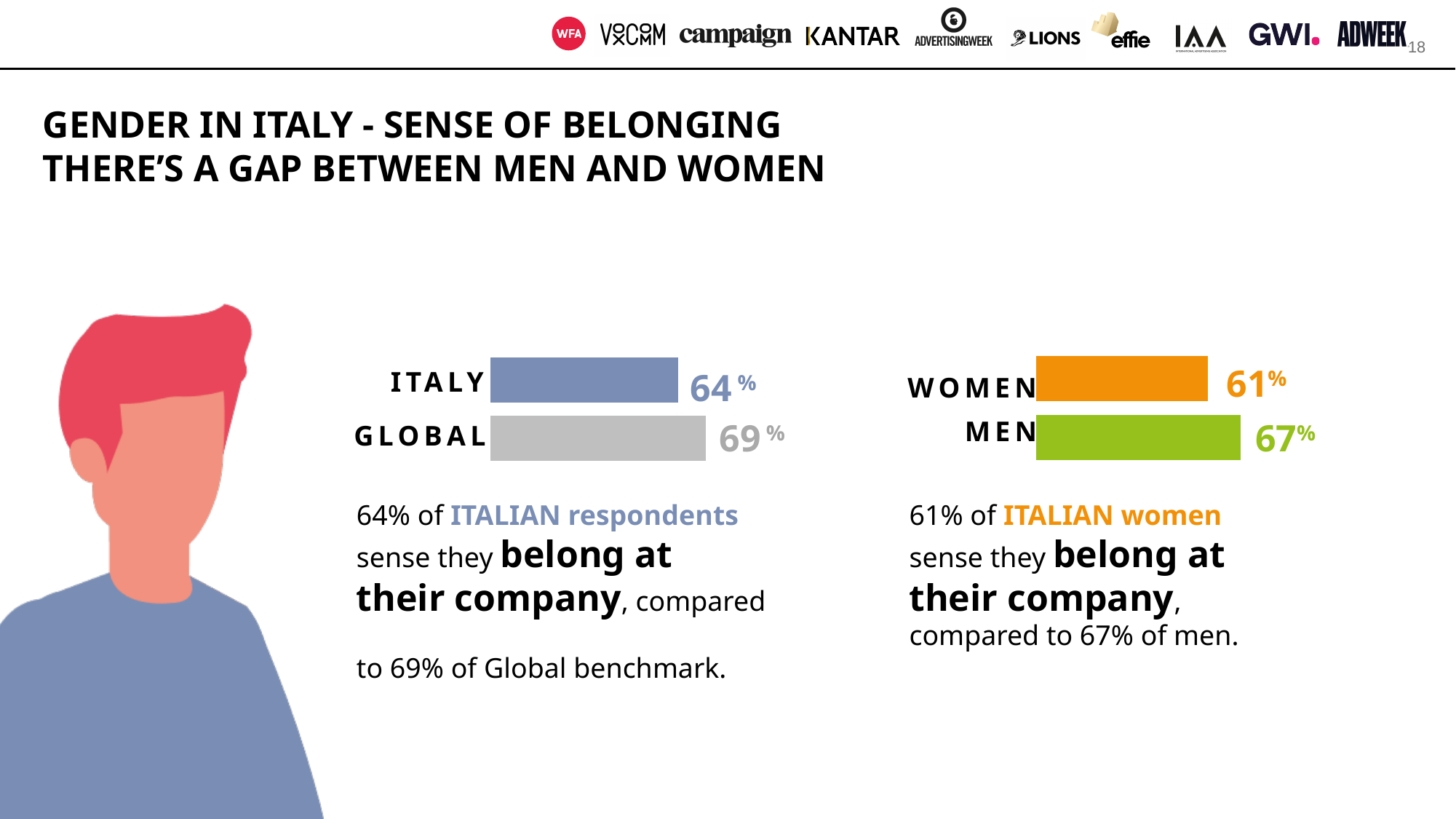
In the left chart (Italy vs Global), what is the difference between the Global and Italy values? 5 percentage points In the right chart (Women vs Men), what colour is the Women bar? orange In the right chart (Women vs Men), which category has the lower value? Women In the left chart (Italy vs Global), what is the value for Italy? 64% In the right chart (Women vs Men), is the value for Men larger or smaller than the value for Women? larger In the right chart (Women vs Men), what is the value for Women? 61% What kind of chart is the right chart (Women vs Men)? bar chart In the left chart (Italy vs Global), what is the value for Global? 69% How many bars does the left chart (Italy vs Global) have? 2 In the right chart (Women vs Men), what is the difference between the Men and Women values? 6 percentage points In the left chart (Italy vs Global), which category has the higher value? Global In the right chart (Women vs Men), what is the value for Men? 67%